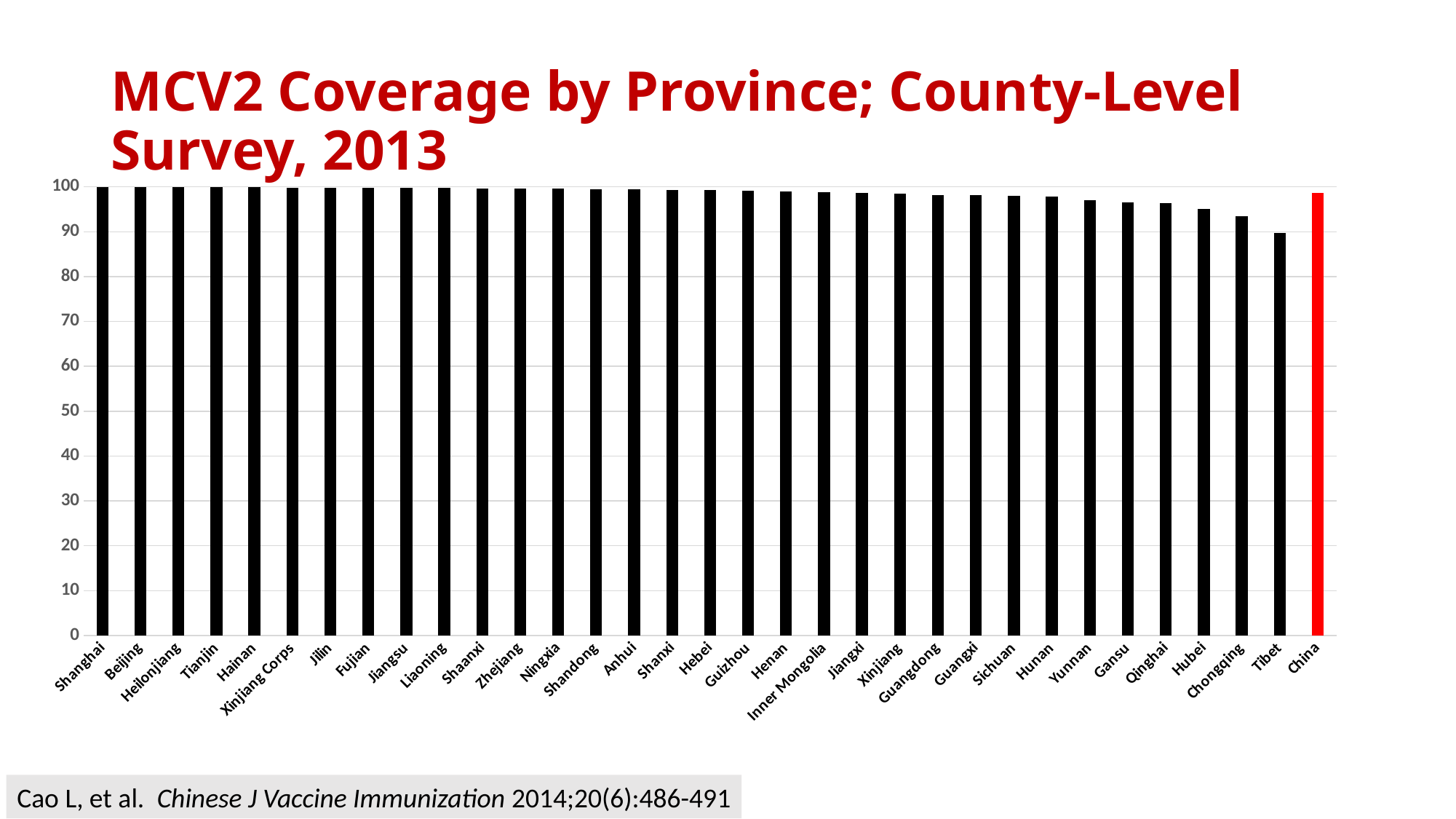
Is the value for Tibet greater or less than 80? greater Is the value for Chongqing greater or less than 90? greater Which has the higher MCV2 coverage, Chongqing or Tibet? Chongqing Which bar in the chart is coloured red? China How many bars are plotted in the chart? 33 Do the bar values generally rise or fall from left to right across the provinces? fall Which province has the lowest MCV2 coverage in the chart? Tibet Which has the higher MCV2 coverage, Shanghai or Tibet? Shanghai What kind of chart is shown on the slide? bar chart What is the title of the chart on the slide? MCV2 Coverage by Province; County-Level Survey, 2013 Is the value for Shanghai greater or less than 90? greater